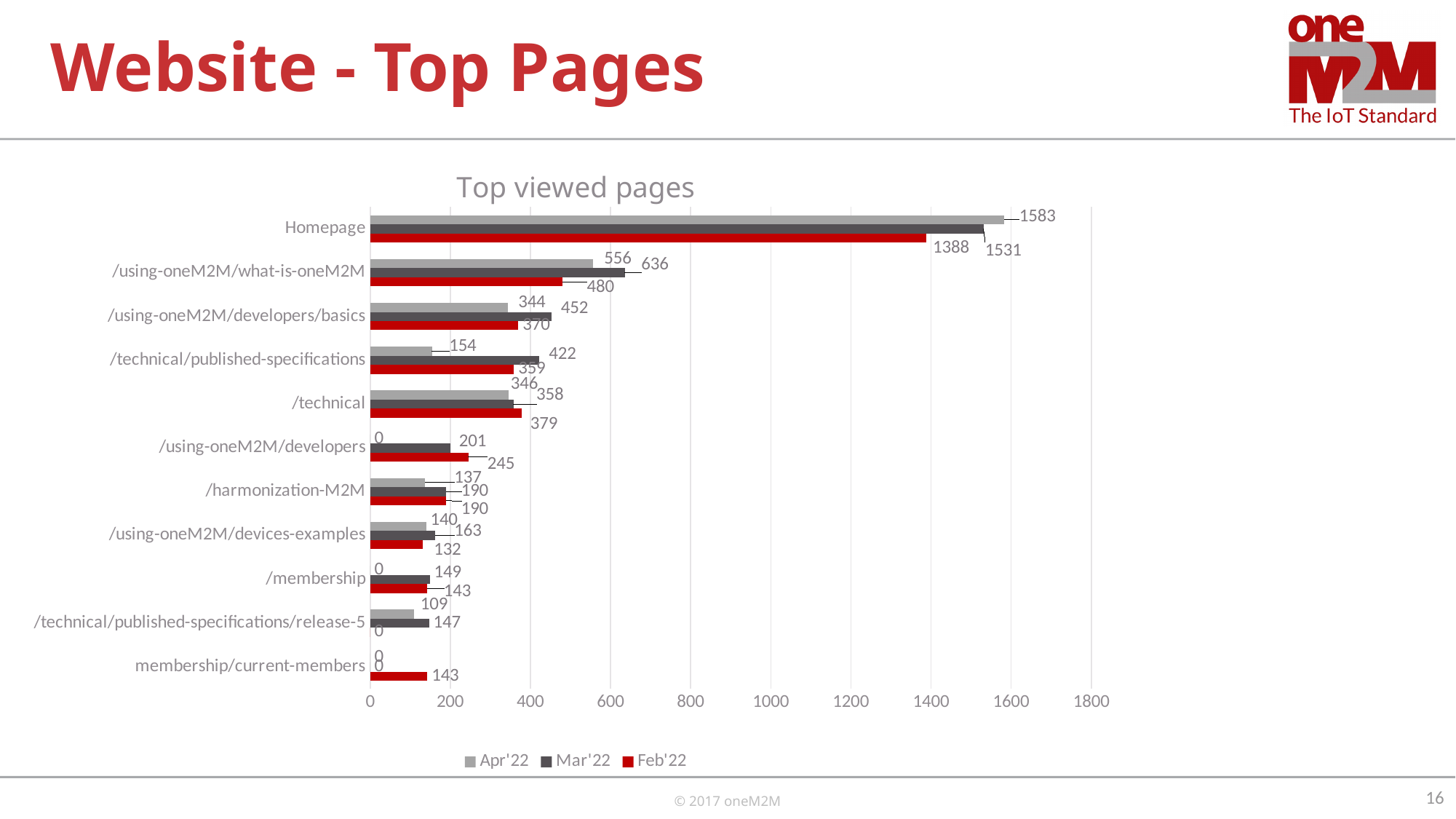
What is the title of the chart? Top viewed pages What type of chart is shown on the slide? bar chart What is the Feb'22 value for /using-oneM2M/what-is-oneM2M? 480 What is the Apr'22 value for Homepage? 1583 What is the difference between the Mar'22 and Apr'22 values for /technical/published-specifications? 268 What is the Feb'22 value for membership/current-members? 143 Which is larger for /using-oneM2M/developers/basics: the Mar'22 value or the Apr'22 value? Mar'22 How many pages (categories) are shown in the chart? 11 Which page has the highest Mar'22 value? Homepage How many series does the legend list? 3 What is the difference between the Apr'22 and Feb'22 values for Homepage? 195 What is the Mar'22 value for /technical/published-specifications? 422